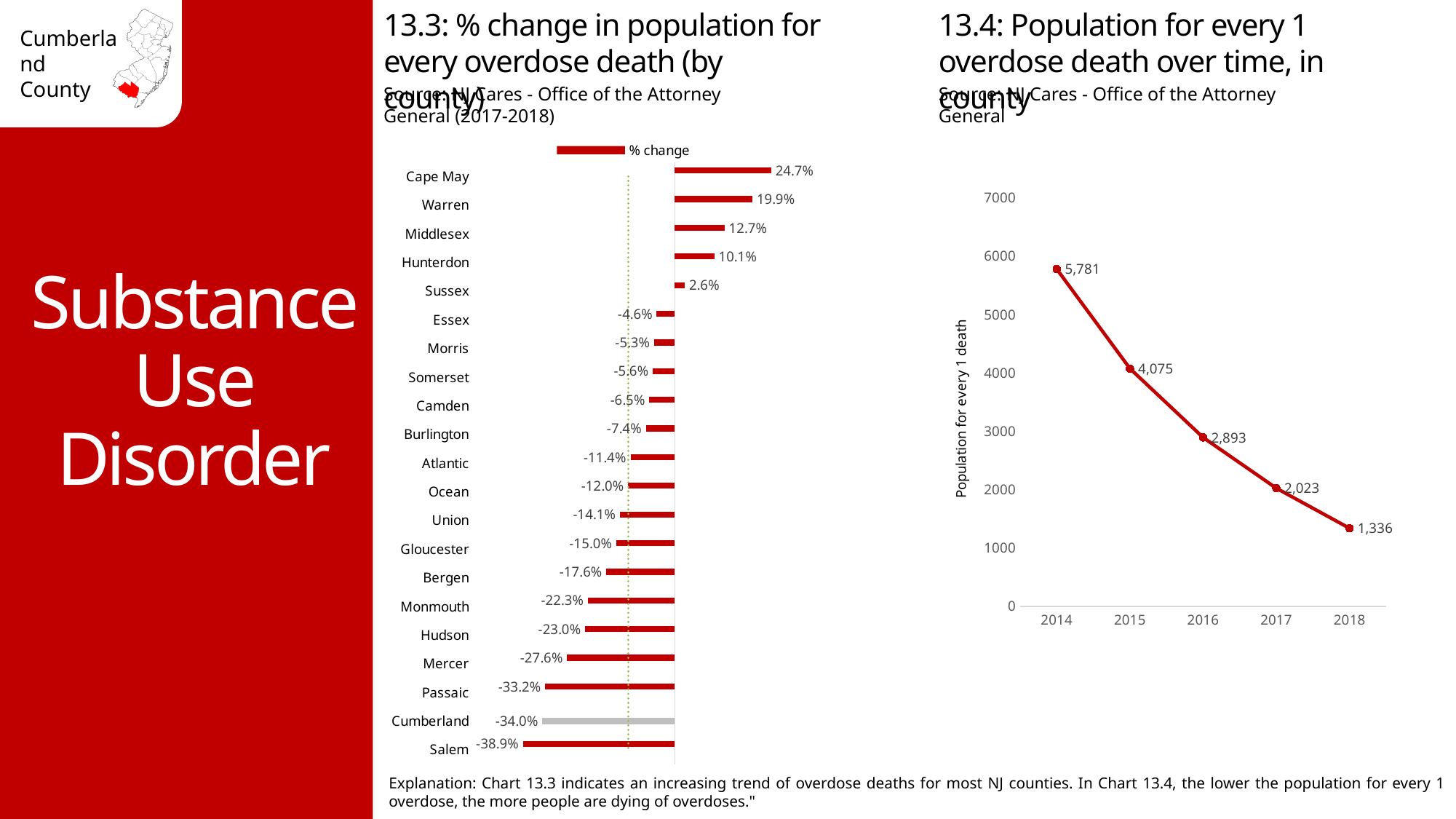
In chart 13.4, what is the population for every 1 overdose death in 2016? 2,893 In chart 13.3, which has a larger % change, Hudson or Mercer? Hudson In chart 13.4, how does the population for every 1 overdose death change from 2014 to 2018? It falls What kind of chart is chart 13.3? Bar chart In chart 13.3, what is the difference between the % change for Warren and Middlesex? 7.2 percentage points In chart 13.4, what is the difference between the 2014 and 2018 values? 4,445 In chart 13.3, what is the % change for Cumberland? -34.0% What kind of chart is chart 13.4? Line chart In chart 13.3, which county has the lowest % change? Salem In chart 13.3, which county has the highest % change? Cape May In chart 13.3, how many counties are listed? 21 In chart 13.3, what is the % change for Cape May? 24.7%